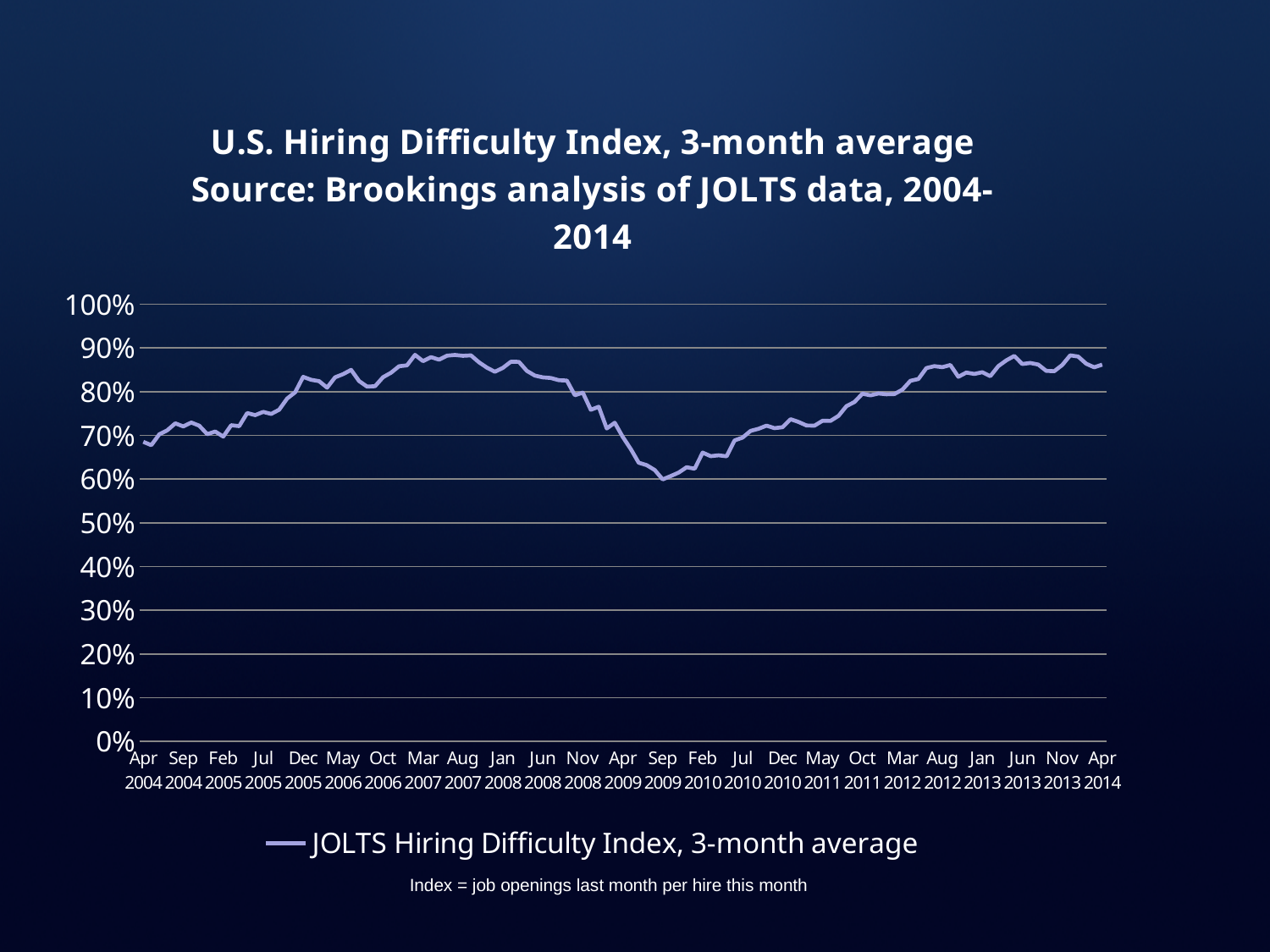
Is the value for Apr 2004 greater or less than 70%? less According to the note below the chart, how is the index defined? job openings last month per hire this month Is the value for Aug 2007 greater or less than 80%? greater Does the index rise or fall between Mar 2007 and Sep 2009? fall What is the legend entry for the plotted series? JOLTS Hiring Difficulty Index, 3-month average How many series does the legend list? 1 Is the value for Feb 2010 greater or less than 70%? less Around which labeled month does the index reach its lowest point? Sep 2009 Does the index rise or fall between Sep 2009 and Jun 2013? rise What kind of chart is shown on the slide? line chart